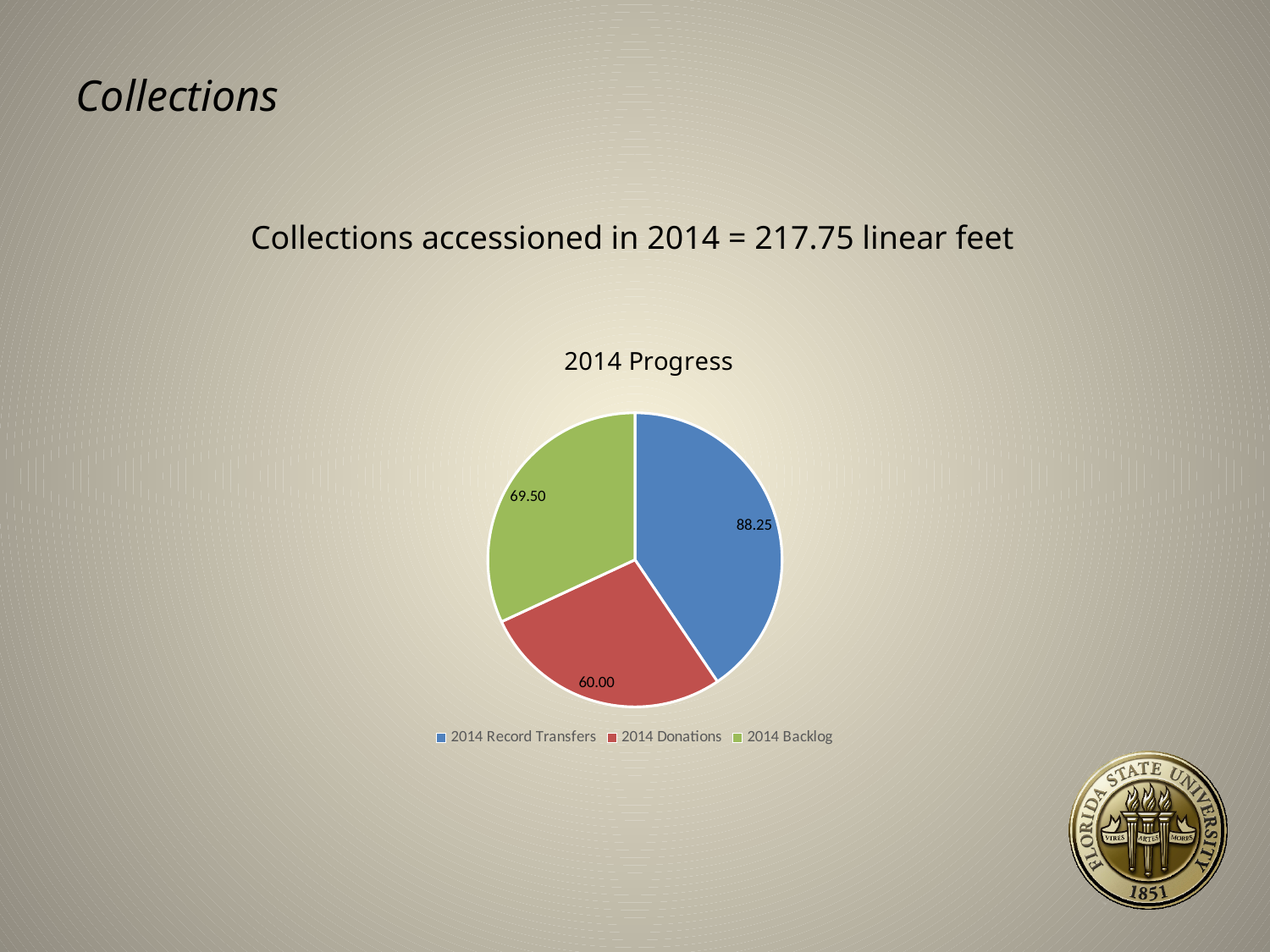
What is the difference between the values for 2014 Record Transfers and 2014 Donations? 28.25 What is the difference between the values for 2014 Backlog and 2014 Donations? 9.50 What is the value for 2014 Backlog? 69.50 What is the title of the chart? 2014 Progress Which is larger, the value for 2014 Backlog or the value for 2014 Donations? 2014 Backlog What colour is the slice for 2014 Backlog? green Which category has the smallest slice of the pie? 2014 Donations What is the value for 2014 Record Transfers? 88.25 Which category has the largest slice of the pie? 2014 Record Transfers What is the value for 2014 Donations? 60.00 How many slices does the pie chart have? 3 What type of chart is shown on the slide? pie chart